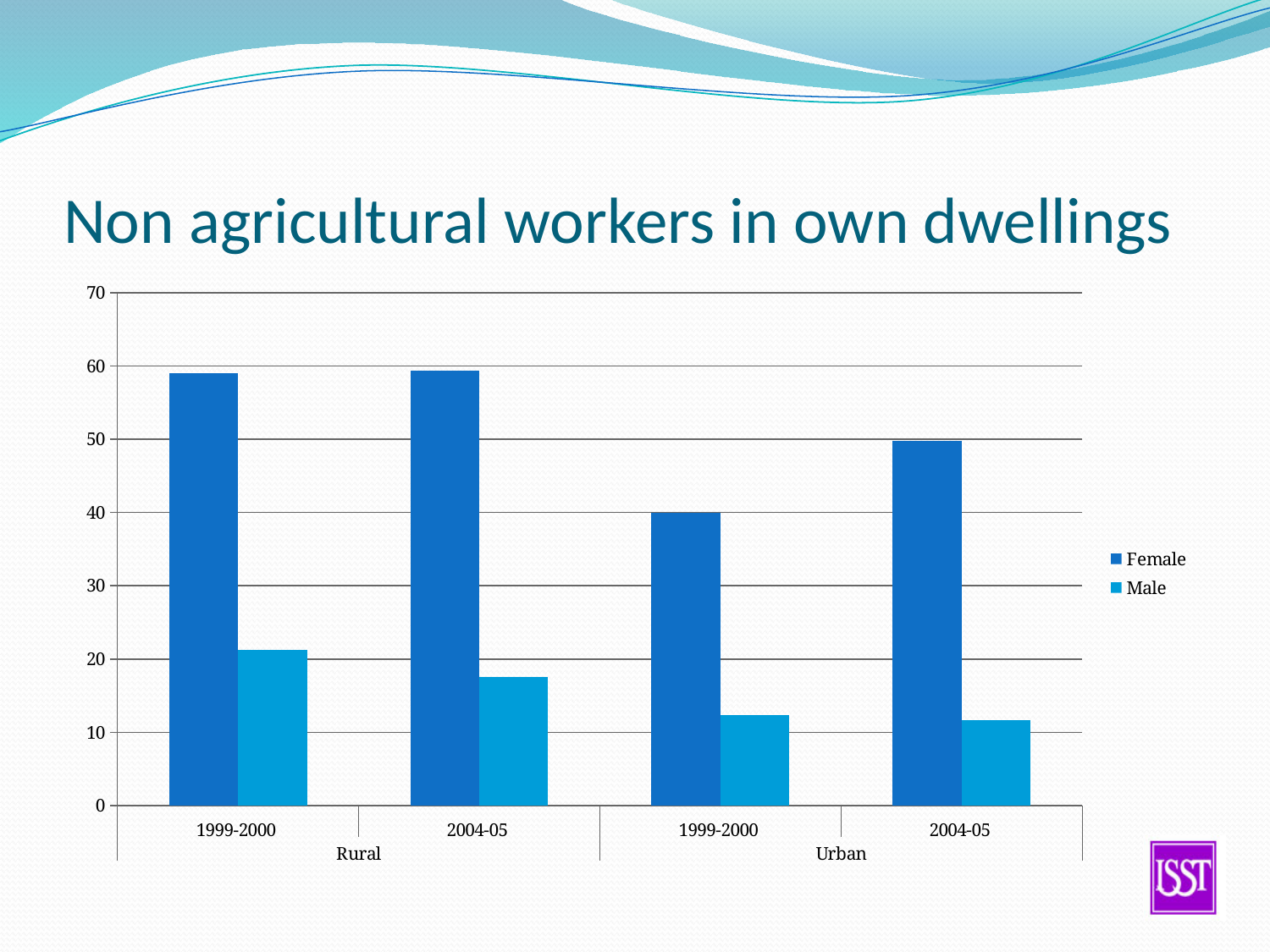
Is the Male value for Rural 2004-05 greater or less than 20? less In Urban 2004-05, which is larger, the Female value or the Male value? Female What is the title of the chart? Non agricultural workers in own dwellings Which category has the lowest Female value? Urban 1999-2000 What kind of chart is shown on the slide? bar chart How many series does the legend list? 2 How many category groups are shown along the x axis? 4 Which category has the highest Male value? Rural 1999-2000 Do the Male values rise or fall from Rural 1999-2000 to Urban 2004-05 along the x axis? fall Is the Female value for Urban 2004-05 greater or less than 40? greater Which series does the legend list? Female and Male